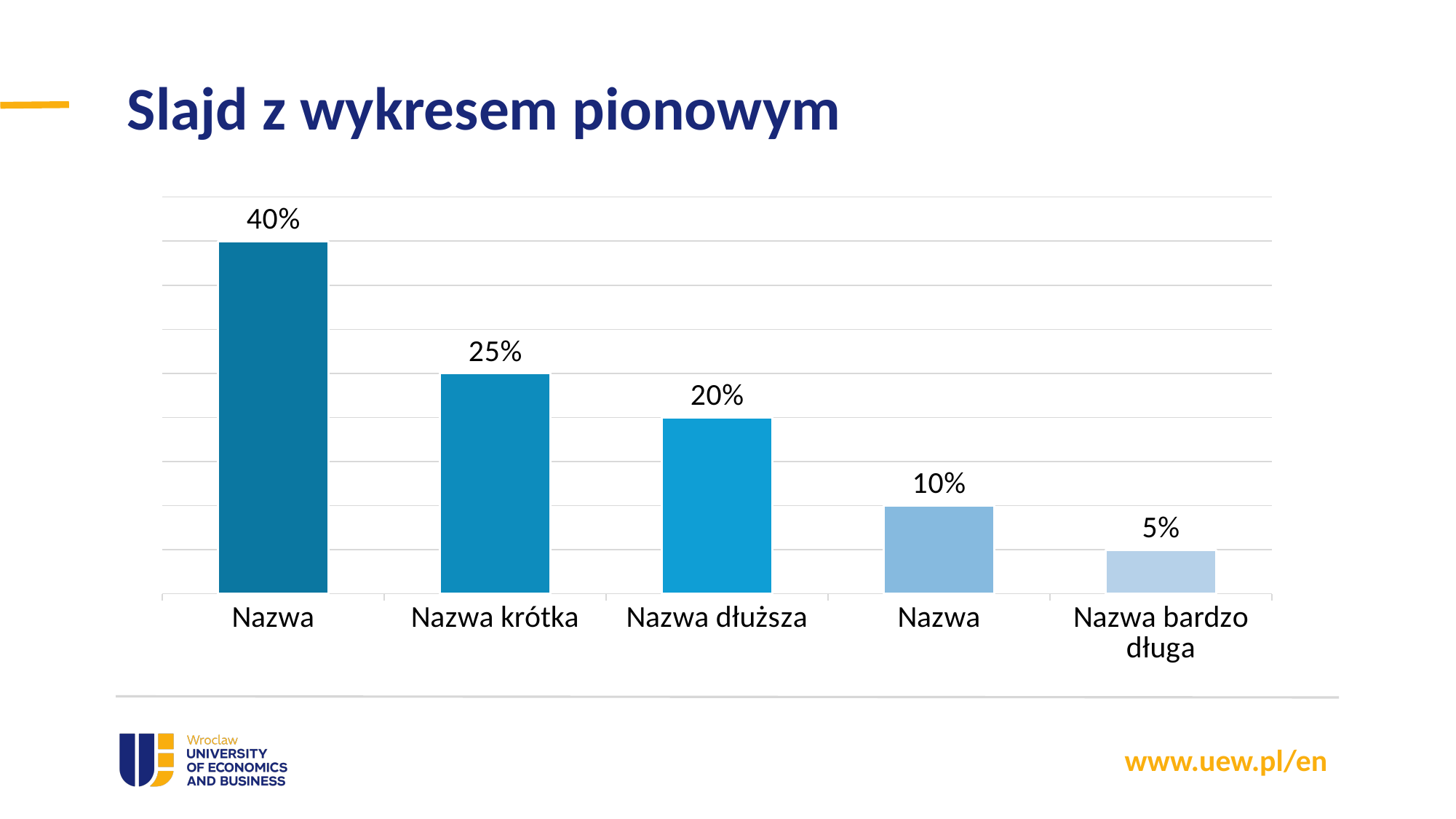
What is the value for Nazwa bardzo długa? 5% Which is larger, the value for Nazwa krótka or the value for Nazwa bardzo długa? Nazwa krótka How many bars does the chart show? 5 Which category has the lowest value? Nazwa bardzo długa What is the value for Nazwa krótka? 25% What is the value of the first bar on the left, labelled Nazwa? 40% Do the values rise or fall from left to right along the x axis? Fall What is the value of the fourth bar, labelled Nazwa? 10% What kind of chart is shown on the slide? Bar chart What is the difference between the first bar (Nazwa, 40%) and Nazwa bardzo długa? 35% What is the value for Nazwa dłuższa? 20% What is the difference between the values for Nazwa krótka and Nazwa dłuższa? 5%